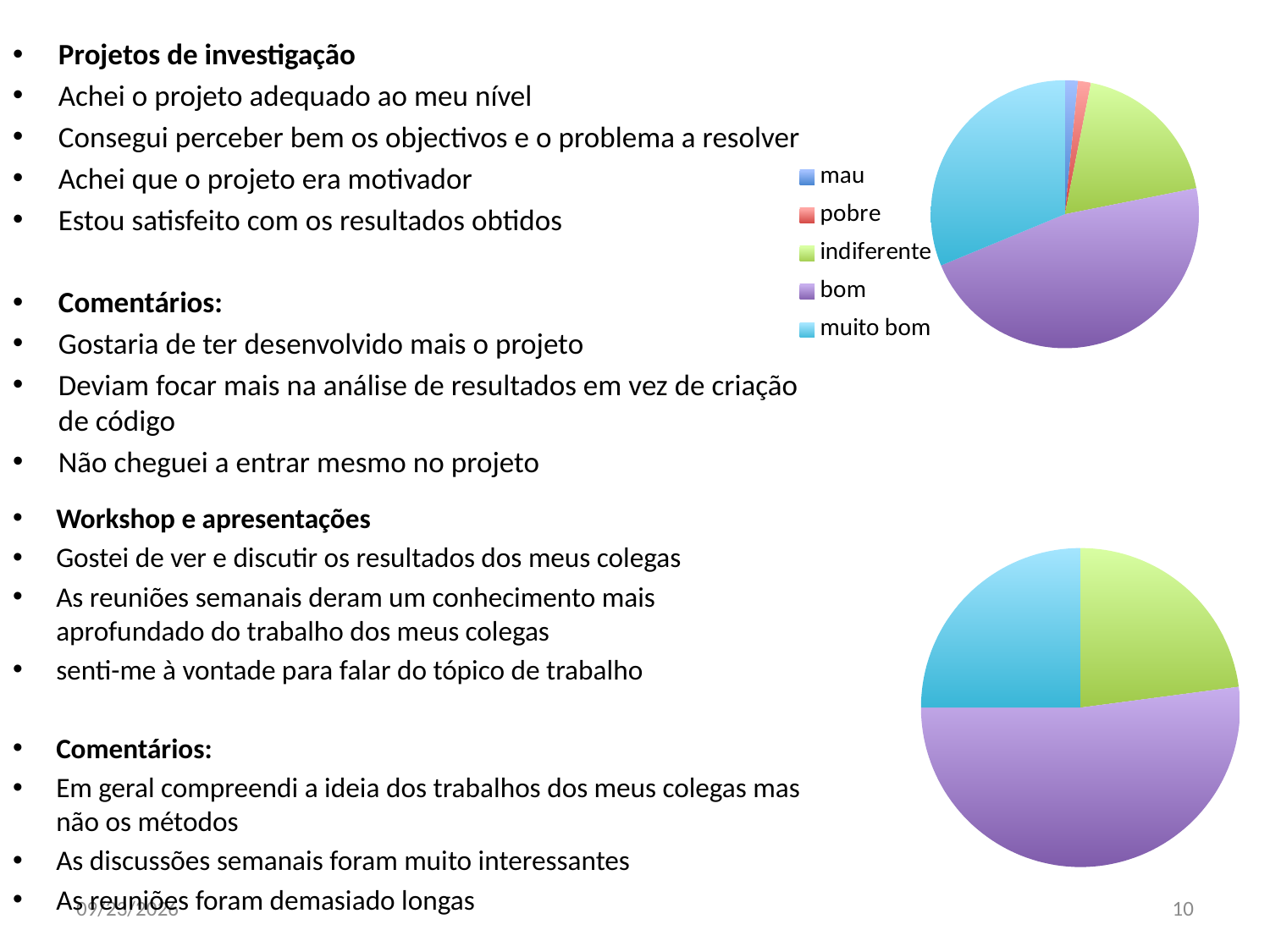
What kind of chart is the top chart on the slide? pie chart In the top pie chart, which slice is larger, indiferente or muito bom? muito bom In the bottom pie chart, which colour is the largest slice? purple In the top pie chart, how many entries does the legend list? 5 In the top pie chart, which slice is larger, pobre or indiferente? indiferente In the top pie chart, which slice is larger, mau or bom? bom What kind of chart is the bottom chart on the slide? pie chart In the top pie chart, what is the first entry listed in the legend? mau How many slices does the bottom pie chart have? 3 In the top pie chart, which category has the largest slice? bom